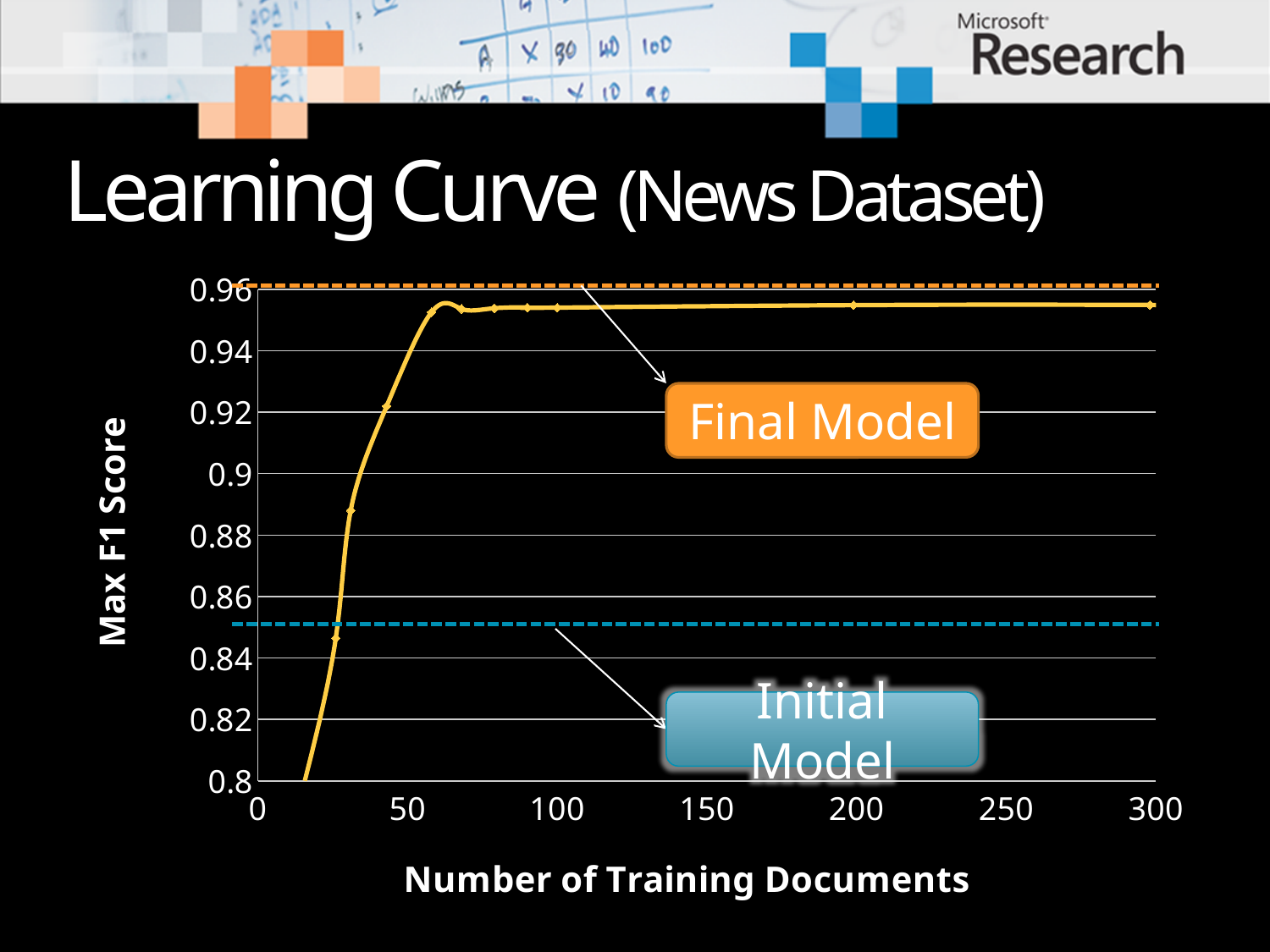
What is the title of the chart on the slide? Learning Curve (News Dataset) Is the Max F1 Score at 25 training documents greater or less than 0.86? less Which has the higher Max F1 Score: 50 training documents or 100 training documents? 100 training documents What is the label of the y axis? Max F1 Score Is the Max F1 Score at 200 training documents greater or less than 0.94? greater What kind of chart is shown on the slide? line chart Is the dashed line labelled Initial Model greater or less than 0.86? less Which dashed reference line is higher on the chart, Final Model or Initial Model? Final Model How does the Max F1 Score change as the number of training documents increases from 0 to 300? rises steeply then levels off